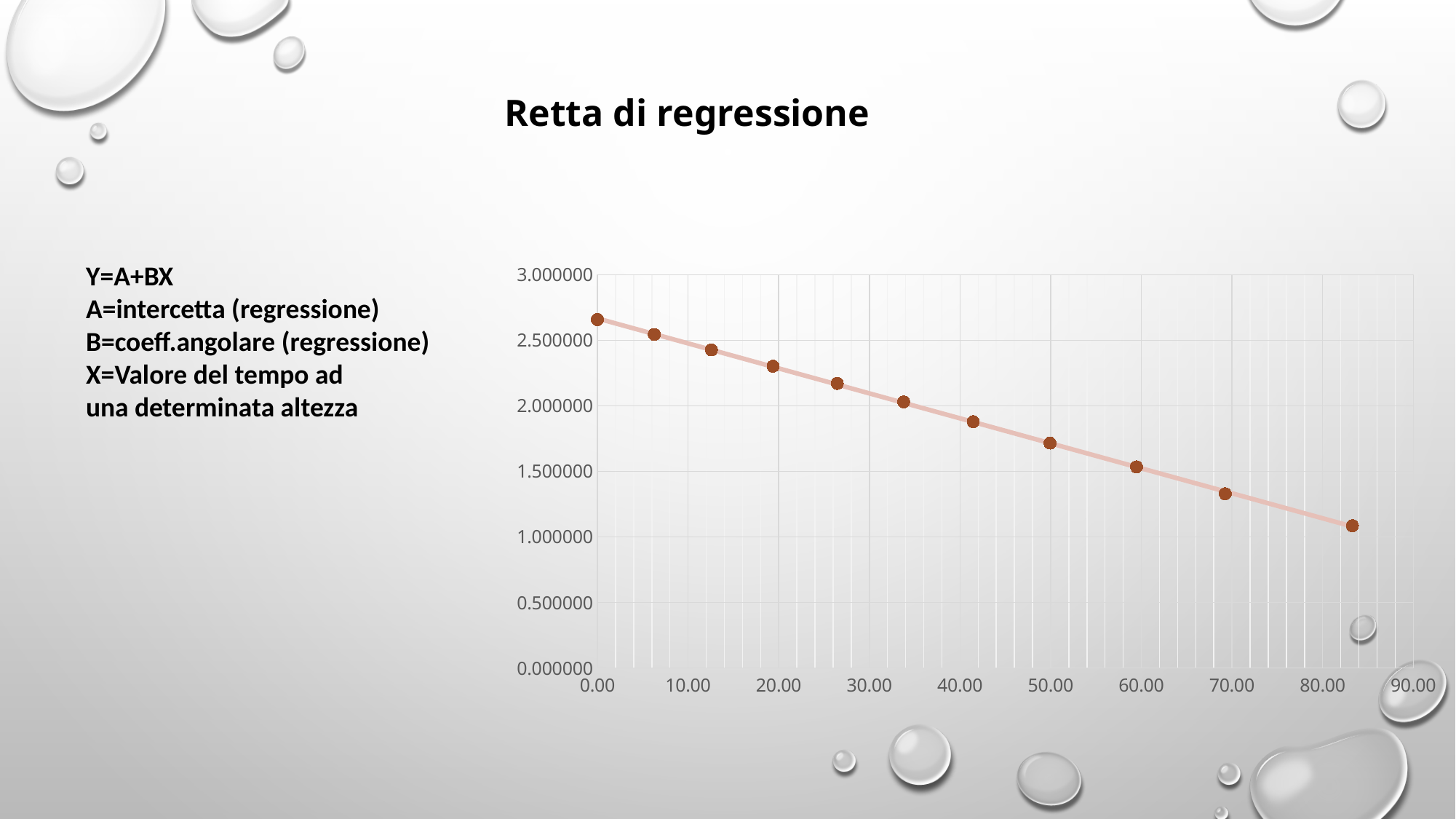
What is the highest tick label shown on the y axis? 3.000000 What is the title of the chart? Retta di regressione How many data points are plotted on the chart? 11 What kind of chart is shown on the slide? scatter chart Is the value of the point at about x = 70 greater or less than 1.500000? less Is the value of the point at x = 0.00 greater or less than 2.500000? greater Is the value of the last point (at about x = 83) greater or less than 1.500000? less Do the plotted values rise or fall as x increases? fall Which point has the highest y value: the first point (x = 0.00) or the last point (x ≈ 83)? the first point (x = 0.00)